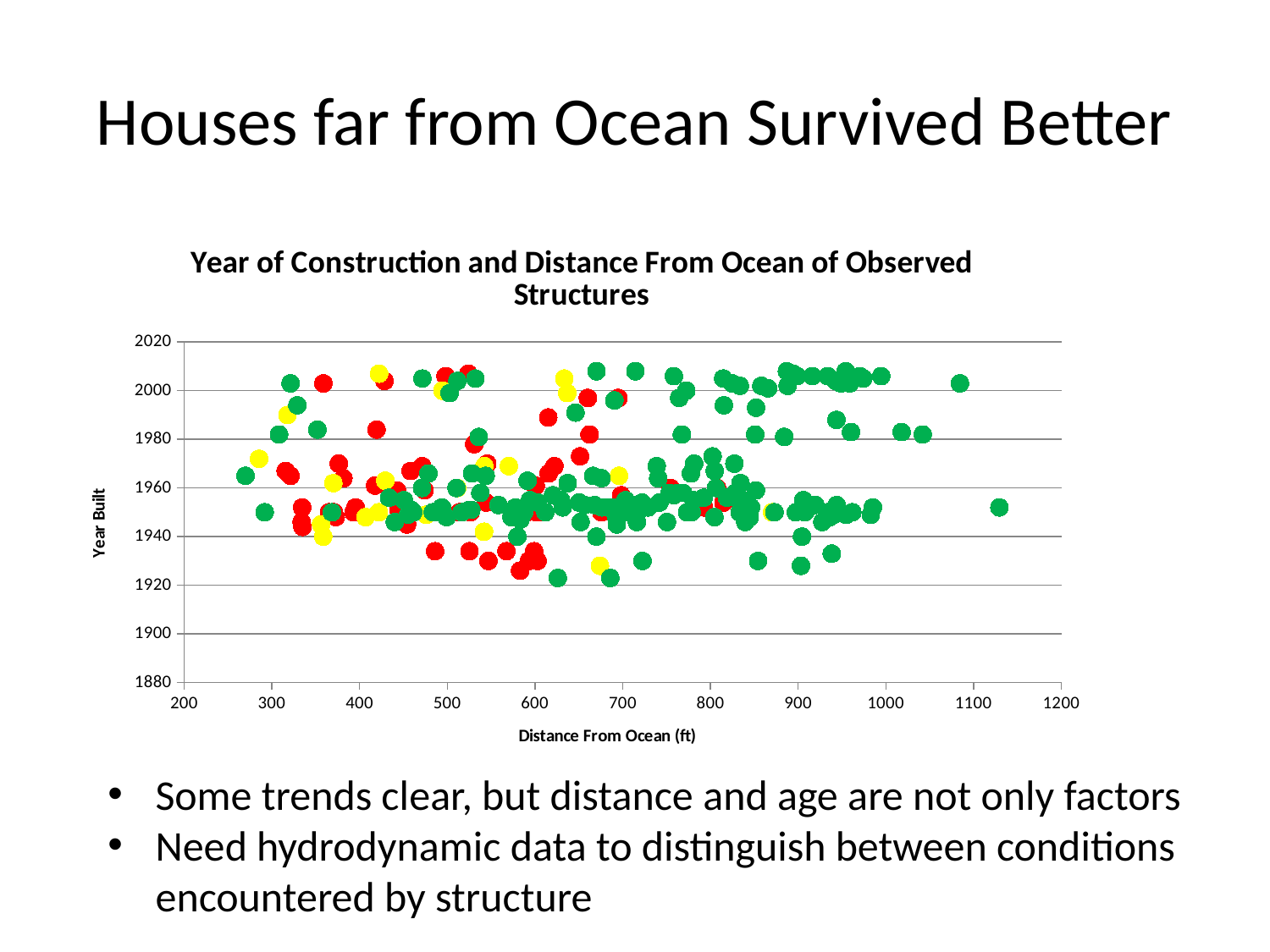
Are any points plotted with a distance from ocean greater than 1200? No Is the Year Built of the earliest-built structure plotted greater or less than 1940? less What is the label of the x axis of the chart? Distance From Ocean (ft) What is the title of the chart? Year of Construction and Distance From Ocean of Observed Structures Is the distance from ocean of the point farthest to the right greater or less than 1100? greater What kind of chart is shown on the slide? Scatter chart